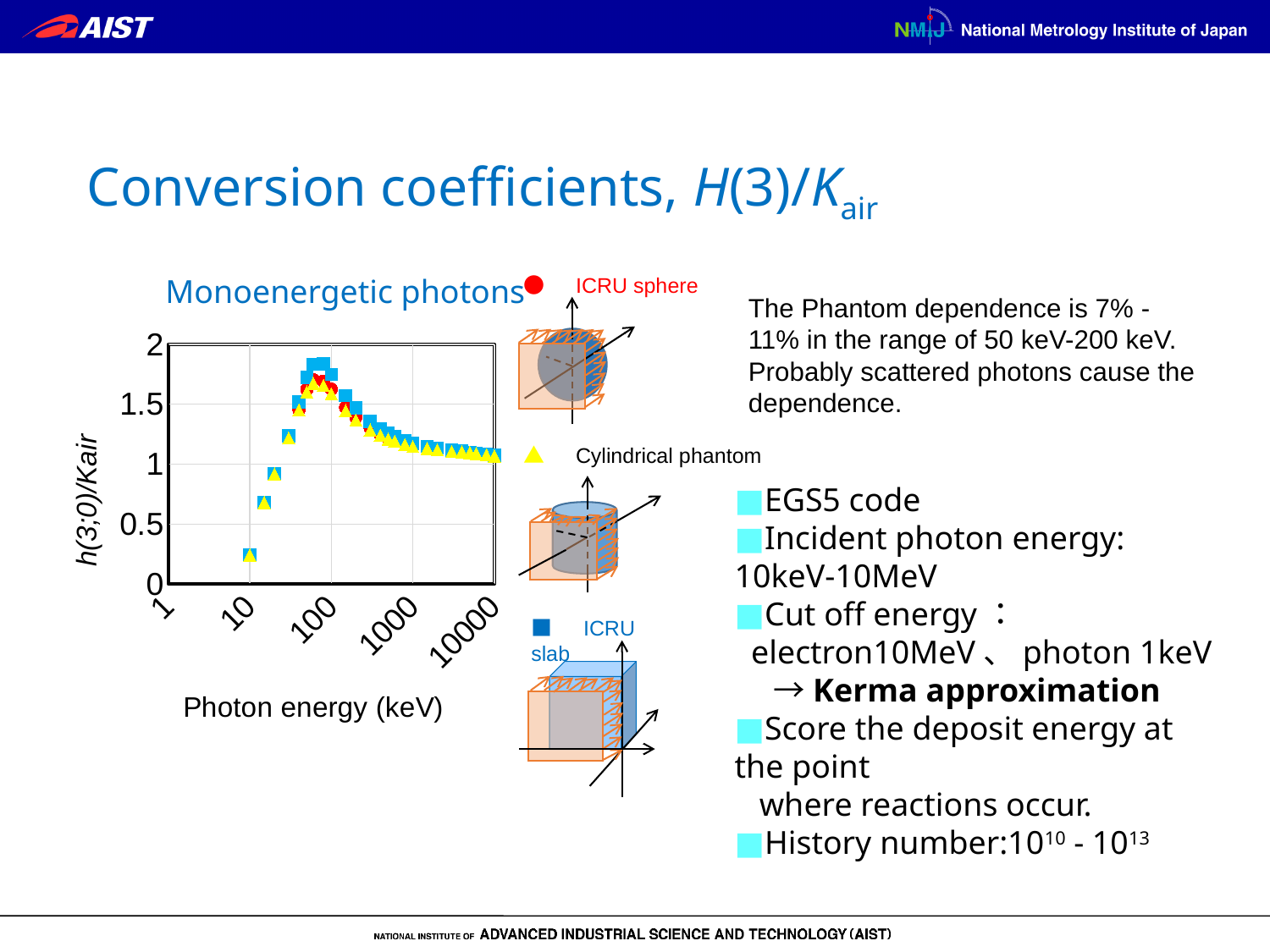
What kind of chart is shown on the slide? scatter chart At the peak of the curve, which series is higher: ICRU slab or Cylindrical phantom? ICRU slab Is the value of h(3;0)/Kair at 10000 keV greater or less than 0.5? greater Is the peak value of the ICRU slab series greater or less than 1.5? greater Do the values rise or fall as photon energy increases from 10 keV to 100 keV? rise How many series (phantom types) are plotted in the chart? 3 What is the title shown above the chart? Monoenergetic photons Is the value of h(3;0)/Kair at 1000 keV greater or less than 1.5? less What is the label of the x axis of the chart? Photon energy (keV) Which series reaches the highest value at the peak of the curve? ICRU slab Do the values rise or fall as photon energy increases from 100 keV to 10000 keV? fall